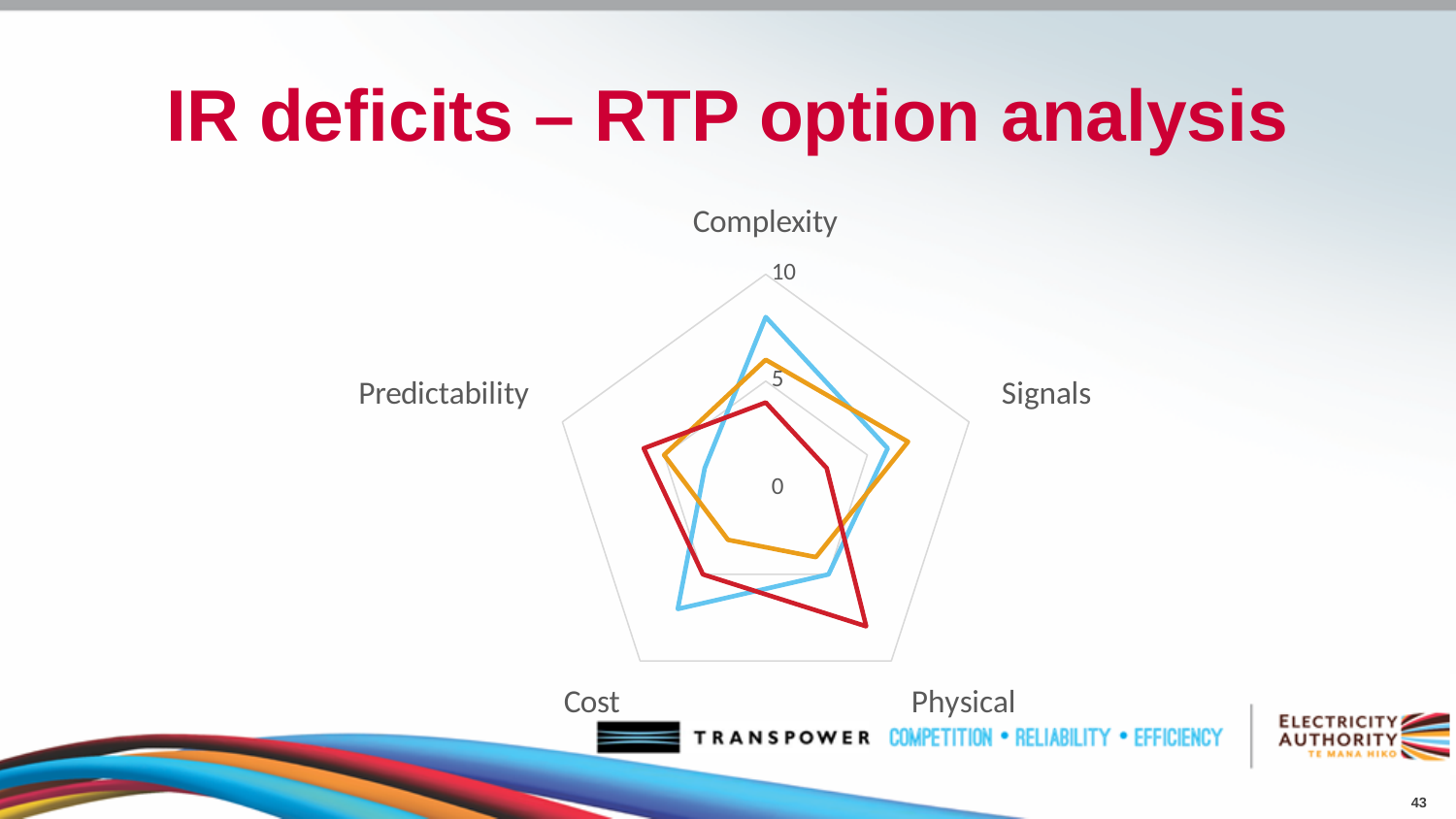
What kind of chart is shown on the slide? Radar chart Is the blue series' value for Cost greater or less than 5? greater What is the maximum value shown on the radar chart's axis scale? 10 How many categories (axes) does the radar chart have? 5 Is the blue series' value for Complexity greater or less than 5? greater For Complexity, which series has the larger value, the blue or the red? Blue For Physical, which series has the larger value, the red or the blue? Red How many series (lines) are plotted on the radar chart? 3 On which axis does the red series reach its highest value? Physical Is the orange series' value for Cost greater or less than 5? less